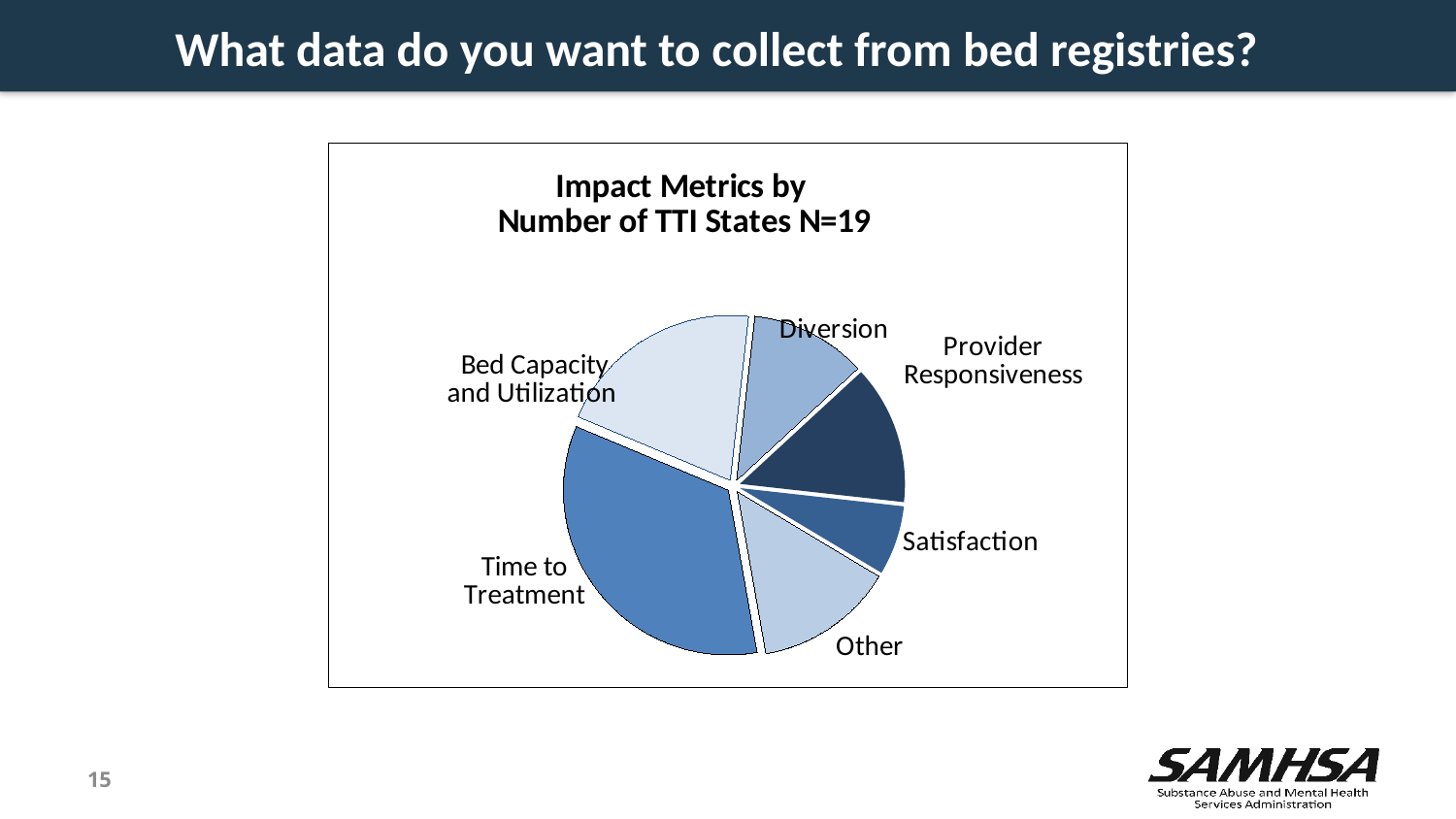
Which slice is larger, Bed Capacity and Utilization or Diversion? Bed Capacity and Utilization How many slices does the pie chart have? 6 Which slice is larger, Bed Capacity and Utilization or Other? Bed Capacity and Utilization What is the title of the chart? Impact Metrics by Number of TTI States N=19 Which slice is larger, Provider Responsiveness or Satisfaction? Provider Responsiveness What is the N (number of TTI states) stated in the chart title? 19 Which category has the largest slice of the pie? Time to Treatment Which category has the smallest slice of the pie? Satisfaction What kind of chart is shown on the slide? pie chart